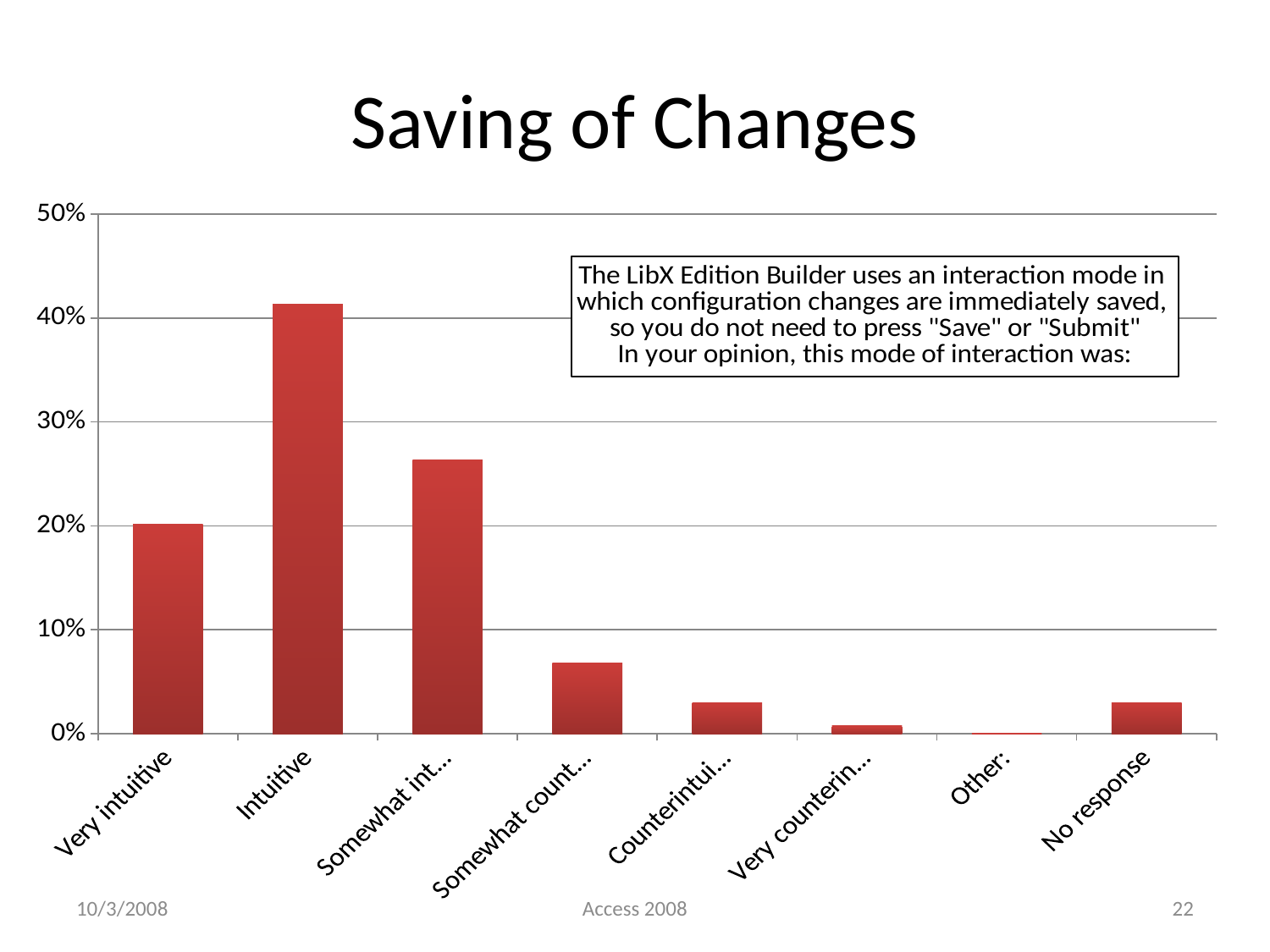
What colour are the bars in the chart? red What kind of chart is shown on the slide? bar chart What is the title of the chart? Saving of Changes How many categories are shown on the x axis of the chart? 8 Which category has the highest value? Intuitive Is the value for Very intuitive greater or less than 10%? greater Which is larger, the value for Very intuitive or the value for Intuitive? Intuitive Is the value for Intuitive greater or less than 30%? greater Is the value for No response greater or less than 10%? less Which category has the lowest value? Other: Which is larger, the value for Very intuitive or the value for No response? Very intuitive